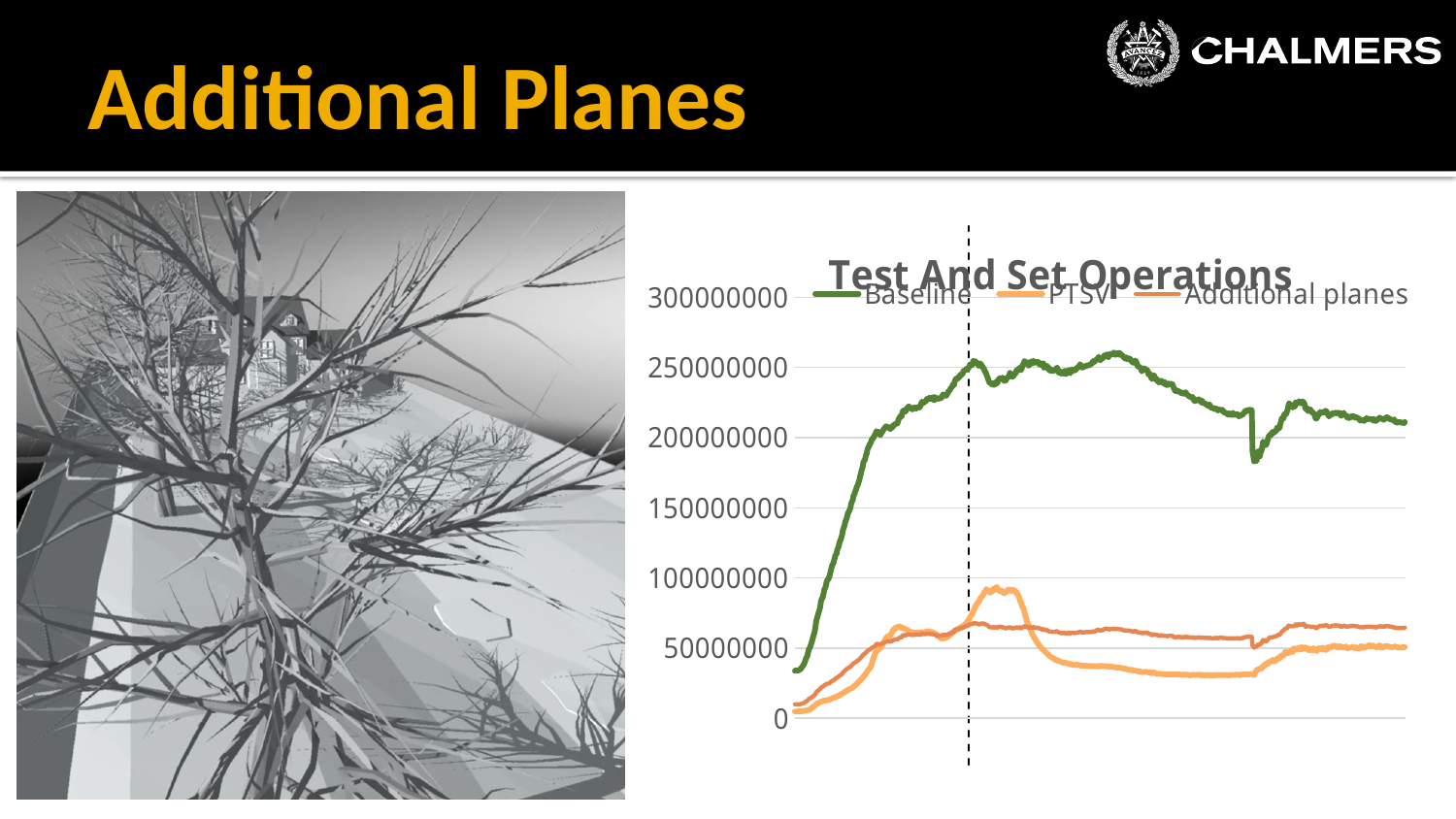
What is the highest value labelled on the y axis? 300000000 Is the peak value of the Additional planes series greater or less than 100000000? less How many series does the chart's legend list? 3 What colour is the Baseline series drawn in? green What kind of chart is shown on the slide? line chart Which series reaches the highest values in the chart? Baseline Is the peak value of the Additional planes series greater or less than 50000000? greater Is the peak value of the Baseline series greater or less than 250000000? greater What is the title of the chart? Test And Set Operations Does the Baseline series rise or fall over the first part of the x axis? rise At the right end of the chart, which series is higher: Baseline or Additional planes? Baseline